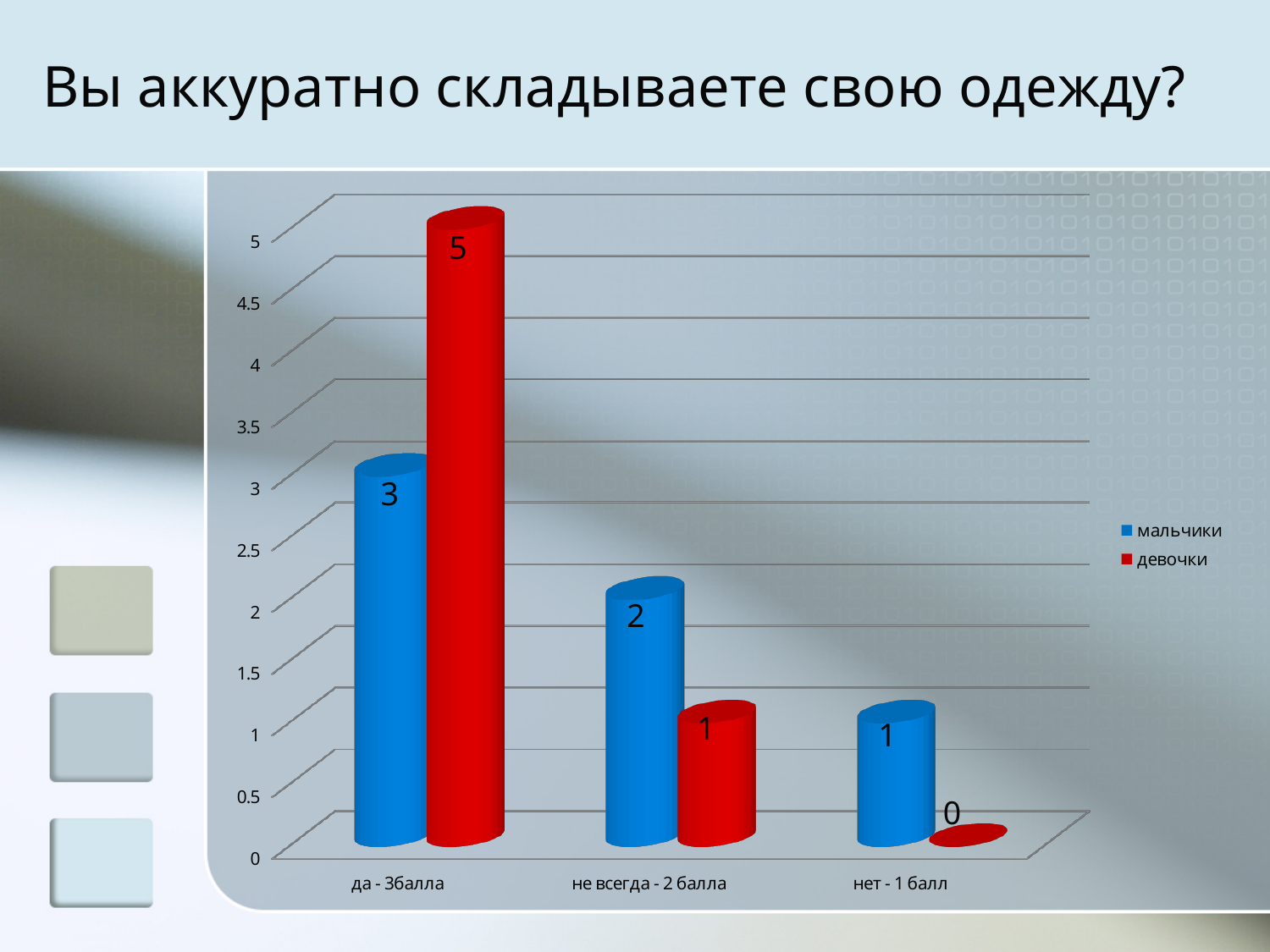
Which category has the highest value for девочки? да - 3балла How many categories are shown on the x axis? 3 Do the values for мальчики rise or fall from left to right along the x axis? fall In the category 'не всегда - 2 балла', which series has the larger value, мальчики or девочки? мальчики What kind of chart is shown on the slide? bar chart How many series does the legend list? 2 What is the value for мальчики in the category 'не всегда - 2 балла'? 2 What is the value for мальчики in the category 'да - 3балла'? 3 What is the value for девочки in the category 'да - 3балла'? 5 What is the difference between девочки and мальчики in the category 'да - 3балла'? 2 What is the value for девочки in the category 'нет - 1 балл'? 0 Which category has the lowest value for мальчики? нет - 1 балл